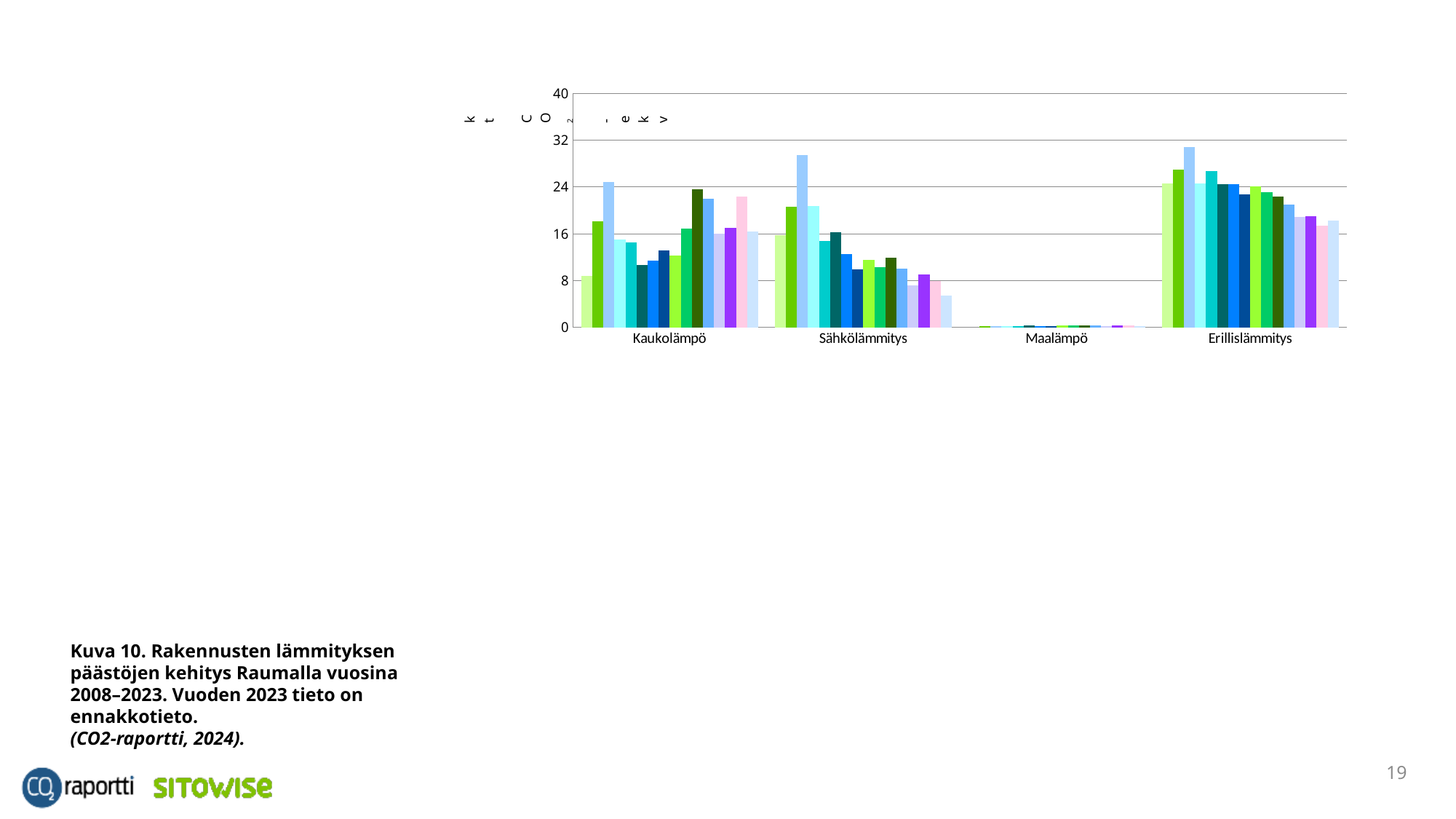
Which category on the x axis has the lowest bars in the chart? Maalämpö Is the tallest bar for Sähkölämmitys greater or less than 24? greater Which category on the x axis contains the tallest bar in the chart? Erillislämmitys Which category has taller bars overall, Maalämpö or Kaukolämpö? Kaukolämpö Is the tallest bar for Erillislämmitys greater or less than 24? greater Is the shortest bar for Sähkölämmitys greater or less than 8? less How many heating categories are shown on the x axis of the chart? 4 Within the Erillislämmitys group, do the bars generally rise or fall from left to right? fall What kind of chart is shown on the slide? bar chart What is the highest value shown on the y axis of the chart? 40